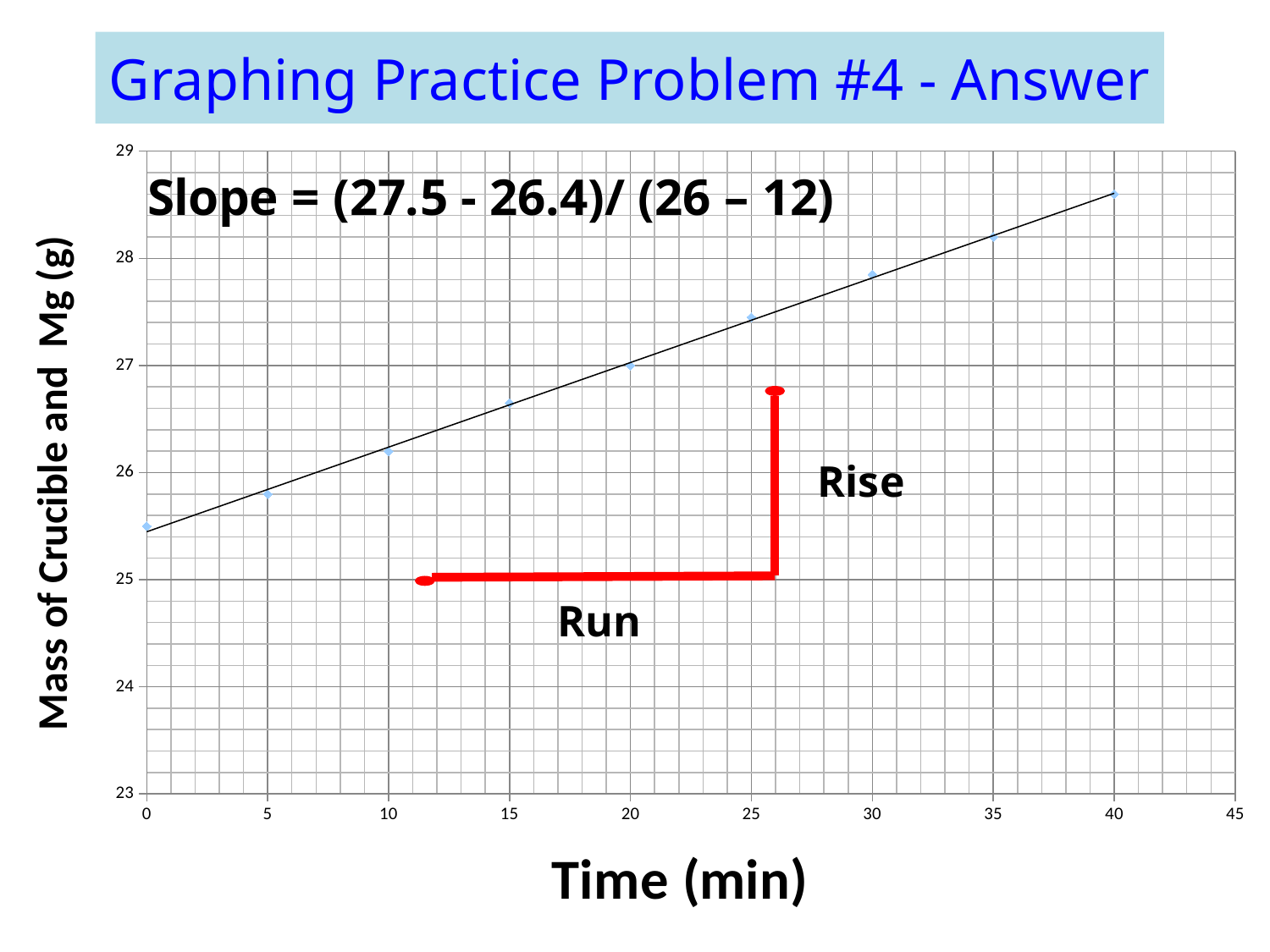
How many data points are plotted on the chart? 9 At which time is the mass of crucible and Mg lowest? 0 min What kind of chart is shown on the slide? scatter plot with a trend line Which has the larger mass, the point at 35 min or the point at 25 min? 35 min Is the mass at 30 min greater or less than 28 g? less At which time is the mass of crucible and Mg highest? 40 min Is the mass at 10 min greater or less than 26 g? greater Do the plotted values rise or fall as time increases along the x axis? rise What is the label of the y axis? Mass of Crucible and Mg (g) What is the label of the x axis? Time (min) Is the mass at 0 min greater or less than 26 g? less